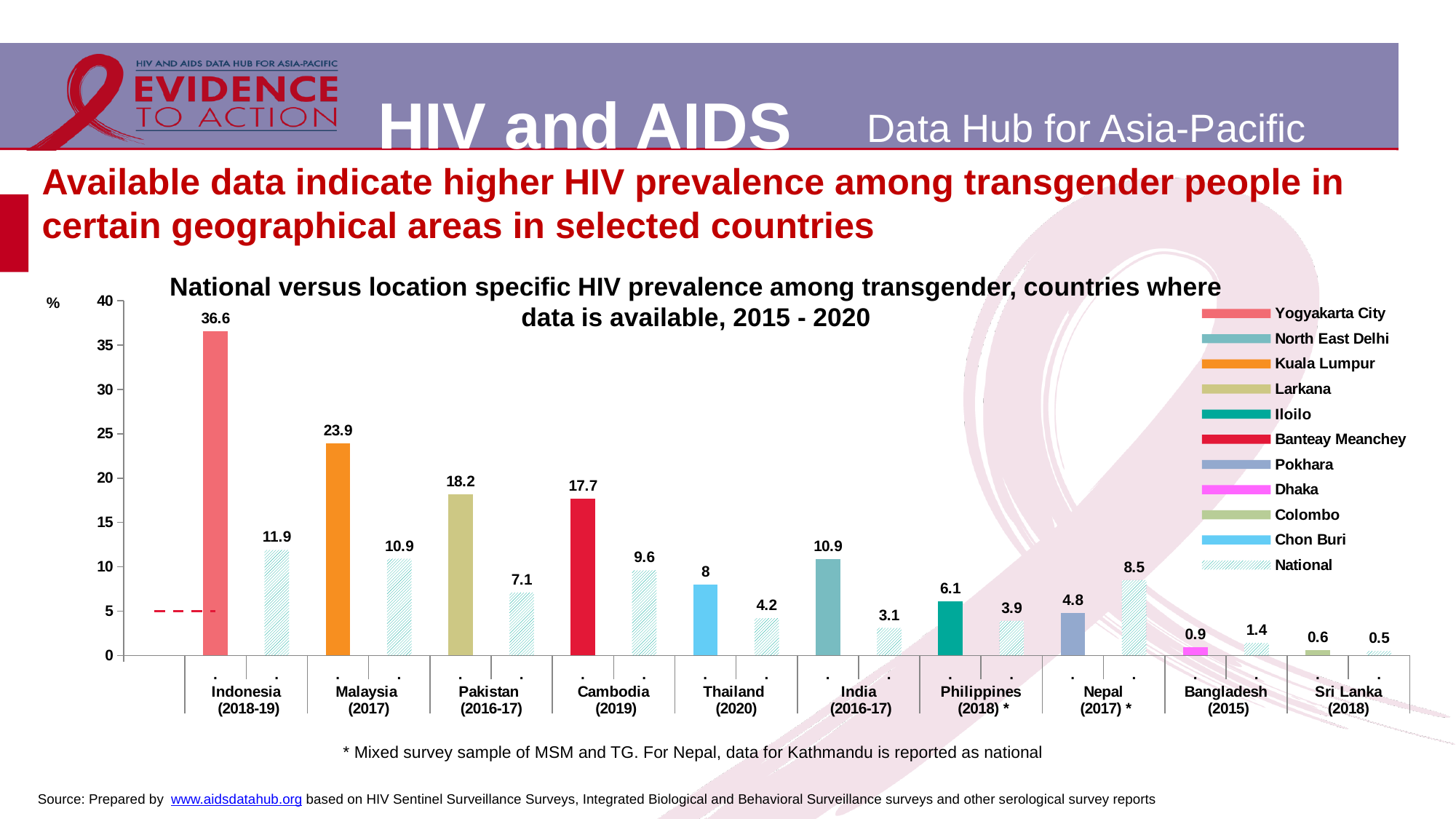
What is the difference between the Kuala Lumpur value and the Malaysia national value? 13 What is the difference between the Larkana value and the Pakistan national value? 11.1 Which country has the lowest national HIV prevalence value on the chart? Sri Lanka What is the value shown for Pokhara (Nepal)? 4.8 What is the value shown for Banteay Meanchey (Cambodia)? 17.7 How many countries are shown on the x axis of the chart? 10 What is the national HIV prevalence value shown for Malaysia (2017)? 10.9 Which location-specific bar has the highest value on the chart? Yogyakarta City How many series does the chart legend list? 11 What type of chart is shown on the slide? Bar chart What is the HIV prevalence value shown for Yogyakarta City (Indonesia)? 36.6 Which is larger for Nepal: the Pokhara value or the national value? National